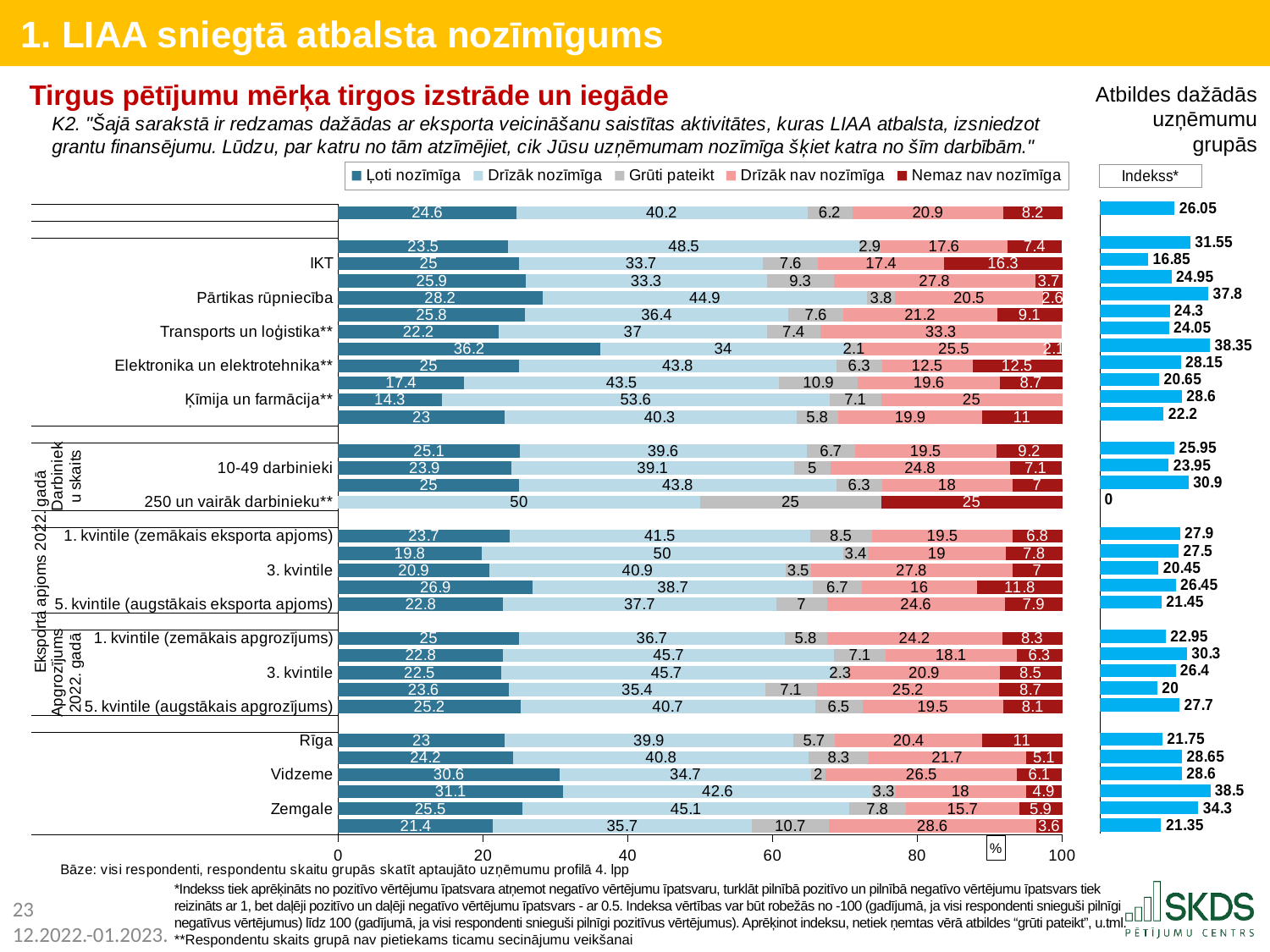
What kind of chart is the main chart on the slide? Stacked bar chart In the Indekss* chart on the right, which of Rīga, Vidzeme and Zemgale has the highest index value? Zemgale How many series does the legend of the stacked bar chart list? 5 In the Indekss* chart on the right, what is the index value for 250 un vairāk darbinieku**? 0 What is the first entry in the legend of the stacked bar chart? Ļoti nozīmīga In the stacked bar chart, which has the larger "Ļoti nozīmīga" value, Vidzeme or Rīga? Vidzeme In the Indekss* chart on the right, what is the index value for Pārtikas rūpniecība? 37.8 In the stacked bar chart, what is the value of "Drīzāk nozīmīga" for Pārtikas rūpniecība? 44.9 In the stacked bar chart, what is the value of "Ļoti nozīmīga" for IKT? 25 In the stacked bar chart, what is the value of "Drīzāk nozīmīga" for Ķīmija un farmācija**? 53.6 In the stacked bar chart, what is the value of "Nemaz nav nozīmīga" for Rīga? 11 In the stacked bar chart, what is the difference between the "Ļoti nozīmīga" values for Pārtikas rūpniecība and IKT? 3.2